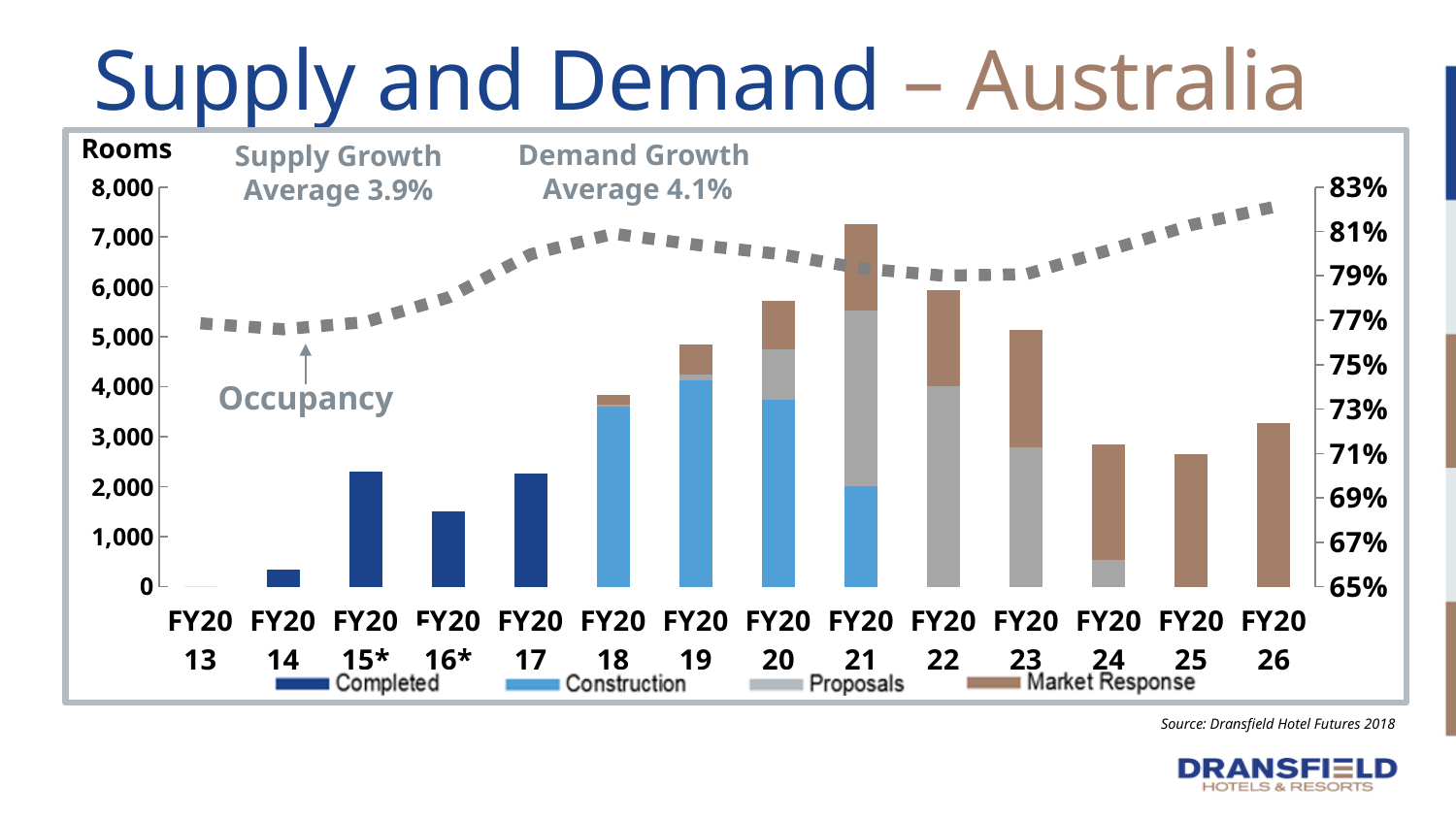
What kind of chart is shown on the slide? combination bar and line chart (stacked bars with an occupancy line) Is the total rooms value for FY2016* greater or less than 2,000? less How many fiscal years are shown on the x axis of the chart? 14 Does the Occupancy line generally rise or fall from FY2013 to FY2026? rise How many series does the chart's legend list? 4 Is the total rooms value for FY2021 greater or less than 7,000? greater Which has the taller stacked bar, FY2023 or FY2024? FY2023 Which has the taller stacked bar, FY2018 or FY2019? FY2019 Is the total rooms value for FY2024 greater or less than 3,000? less Which fiscal year has the smallest stacked bar? FY2013 What is the Supply Growth Average stated on the chart? 3.9% Which fiscal year has the tallest stacked bar? FY2021